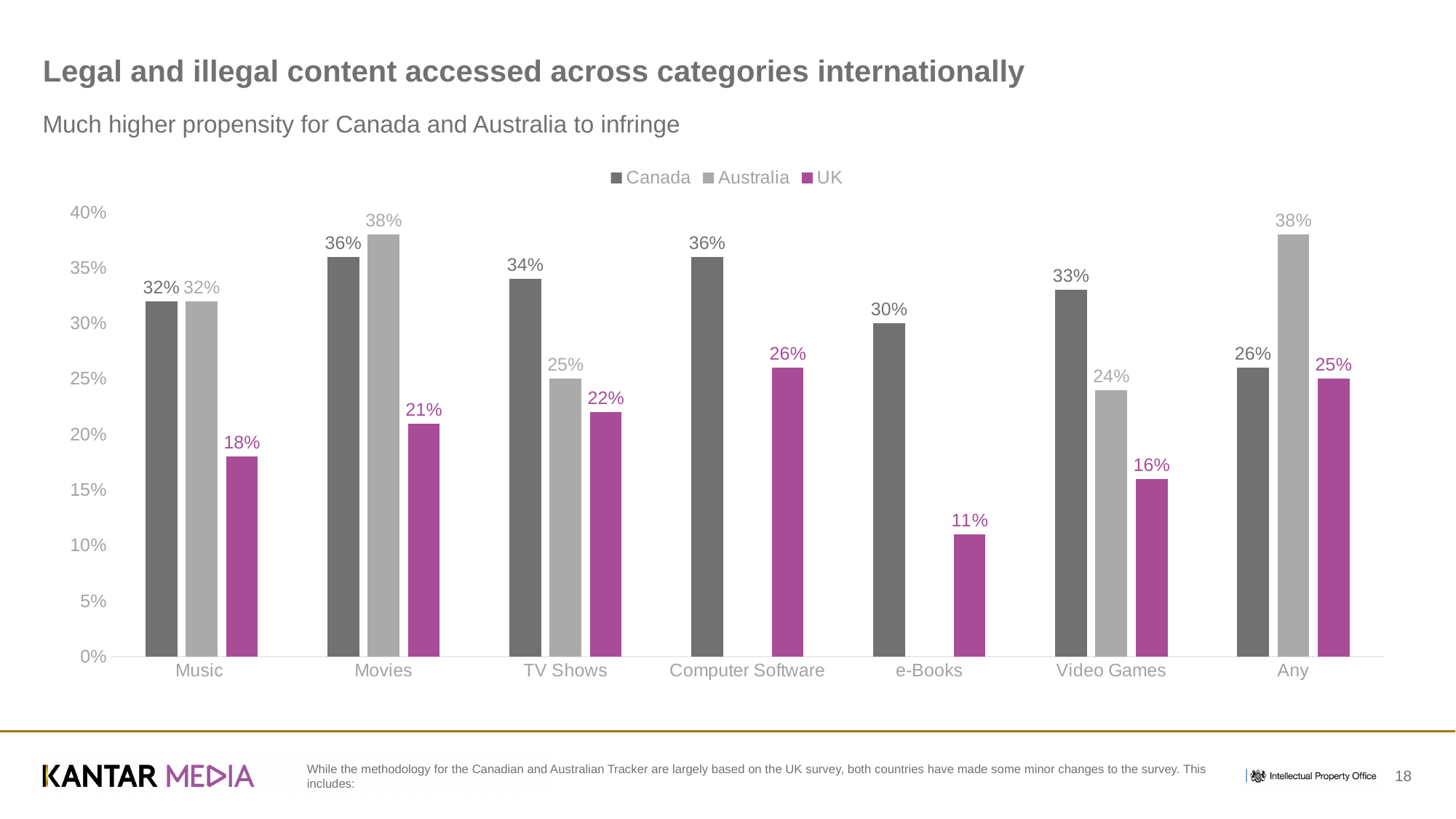
What is the value for Canada in the e-Books category? 30% How many series does the legend list? 3 Is the UK value for Computer Software greater or less than 25%? greater How many categories are shown on the x axis? 7 Which is larger in the Any category, the Canada value or the Australia value? Australia What is the value for Australia in the Movies category? 38% What is the value for the UK in the Music category? 18% Which category has the lowest value for the UK? e-Books What kind of chart is shown on the slide? Bar chart Which category has the highest value for Canada? Movies and Computer Software (both 36%) What is the difference between the Canada and UK values for Video Games? 17 percentage points Which series is shown in purple? UK